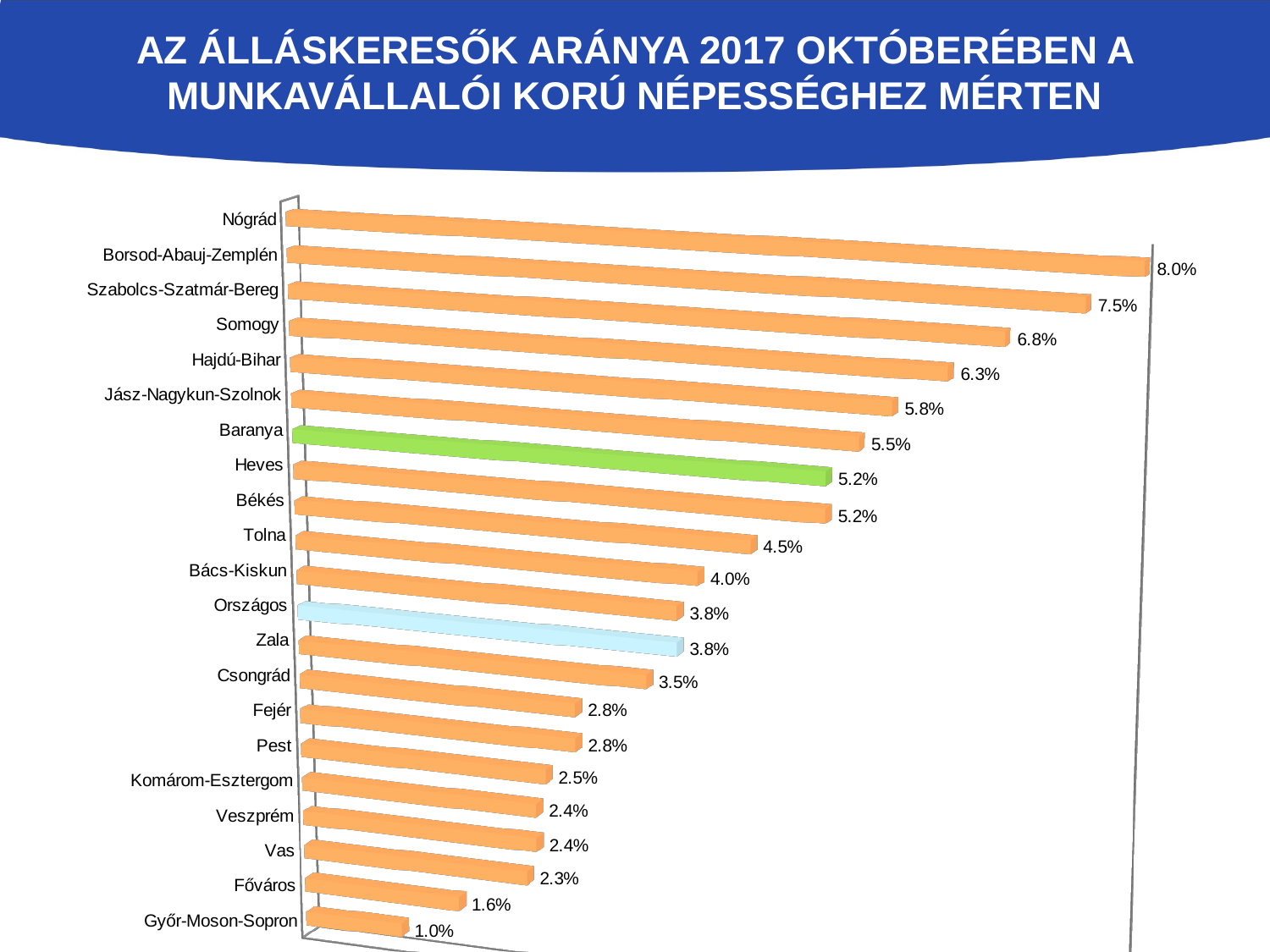
What is the value for Nógrád? 8.0% What is the value for Győr-Moson-Sopron? 1.0% Which is larger, the value for Somogy or the value for Tolna? Somogy What kind of chart is shown on the slide? Bar chart Which category's bar is coloured green? Baranya Which category has the highest value? Nógrád Which category has the lowest value? Győr-Moson-Sopron What is the difference between the values for Baranya and Országos? 1.4% What is the difference between the values for Nógrád and Borsod-Abaúj-Zemplén? 0.5% How many categories are shown in the chart? 21 What is the value for Országos? 3.8% What is the value for Baranya? 5.2%